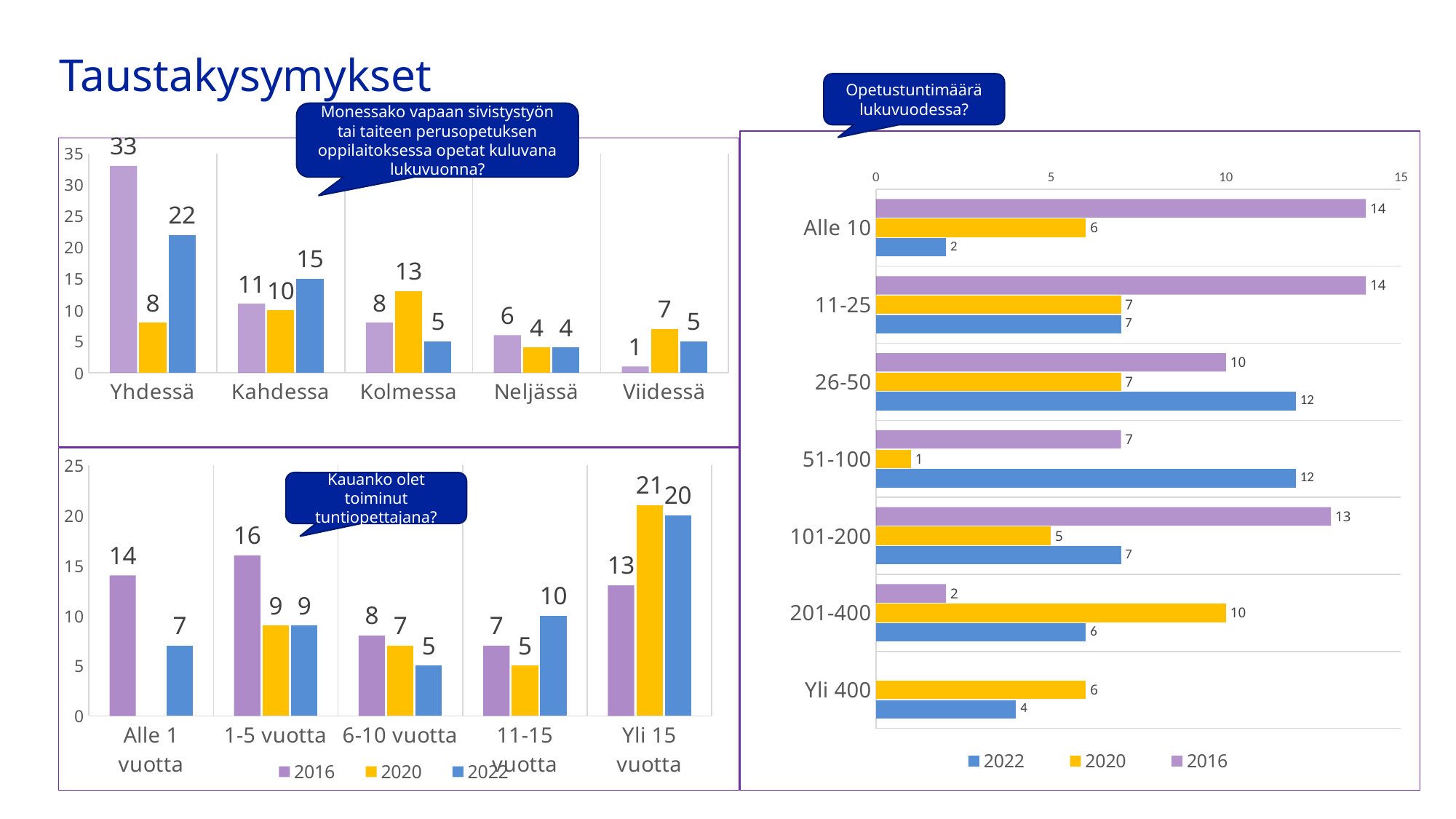
What kind of chart is the right-hand chart (Opetustuntimäärä lukuvuodessa?)? Bar chart In the right-hand chart, which category has the highest 2020 value? 201-400 In the bottom-left chart, how many series does the legend list? 3 In the right-hand chart (Opetustuntimäärä lukuvuodessa?), what is the 2022 value for 26-50? 12 In the top-left chart, how many categories are shown on the x axis? 5 In the bottom-left chart, which is larger for 11-15 vuotta: the 2016 value or the 2022 value? 2022 In the top-left chart, which category has the highest 2022 value? Yhdessä In the top-left chart (Monessako vapaan sivistystyön tai taiteen perusopetuksen oppilaitoksessa opetat kuluvana lukuvuonna?), what is the 2016 value for Yhdessä? 33 In the bottom-left chart (Kauanko olet toiminut tuntiopettajana?), what is the 2020 value for Yli 15 vuotta? 21 In the top-left chart, what is the 2020 value for Kolmessa? 13 In the bottom-left chart, which category has the lowest 2022 value? 6-10 vuotta In the top-left chart, what is the difference between the 2016 and 2020 values for Yhdessä? 25